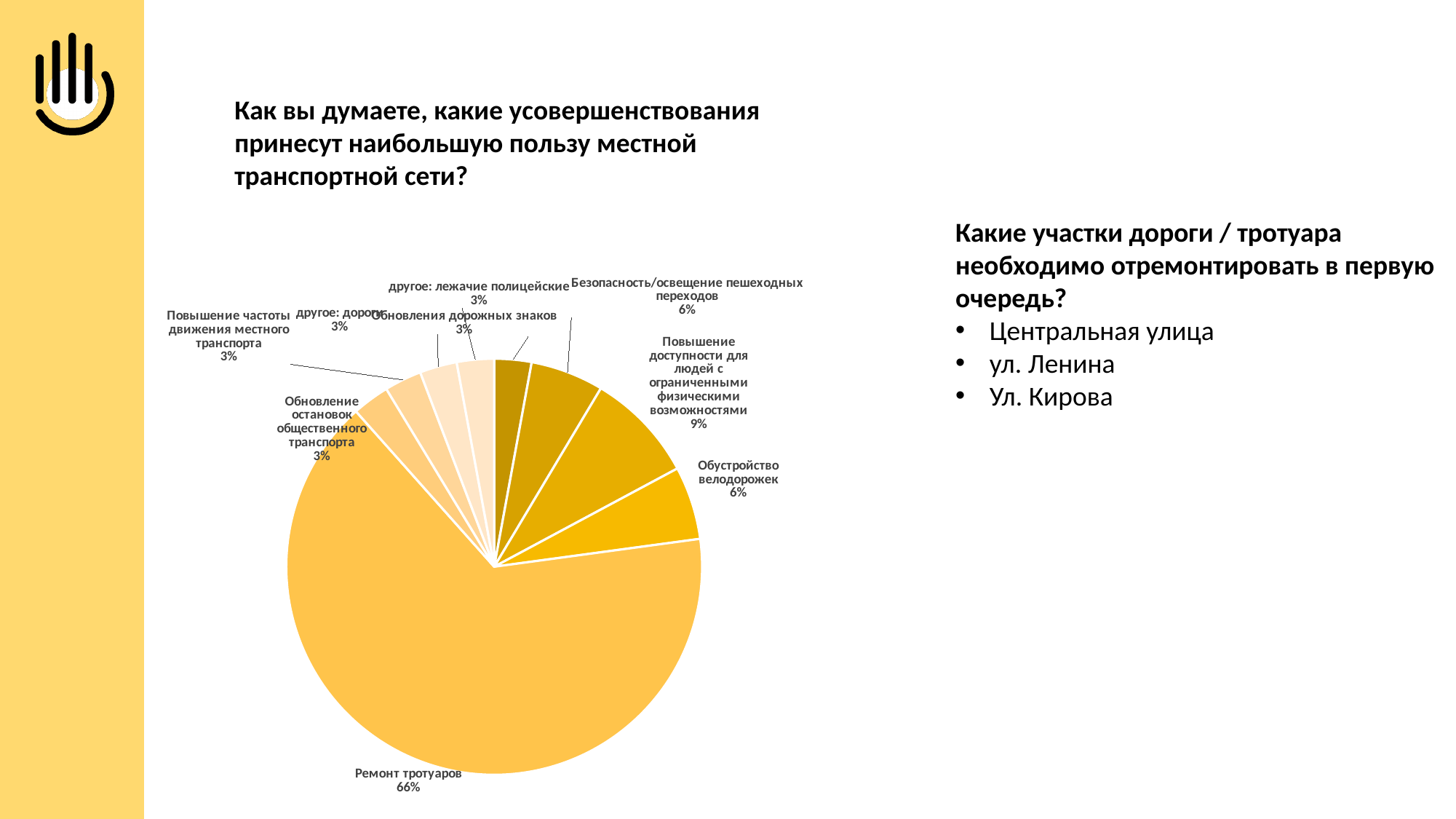
What share of the pie does "Повышение доступности для людей с ограниченными физическими возможностями" have? 9% What is the difference in percentage points between "Ремонт тротуаров" and "Повышение доступности для людей с ограниченными физическими возможностями"? 57 What question does the pie chart answer, according to the heading above it? Как вы думаете, какие усовершенствования принесут наибольшую пользу местной транспортной сети? How many slices does the pie chart have? 9 What share of the pie does "Обустройство велодорожек" have? 6% Which category has the largest slice of the pie? Ремонт тротуаров Which is larger: the slice for "Обустройство велодорожек" or the slice for "другое: дороги"? Обустройство велодорожек What is the difference in percentage points between "Повышение доступности для людей с ограниченными физическими возможностями" and "Обновления дорожных знаков"? 6 What share of the pie does "Безопасность/освещение пешеходных переходов" have? 6% What kind of chart is shown on the slide? Pie chart What share of the pie does "Ремонт тротуаров" have? 66% What share of the pie does "Обновление остановок общественного транспорта" have? 3%